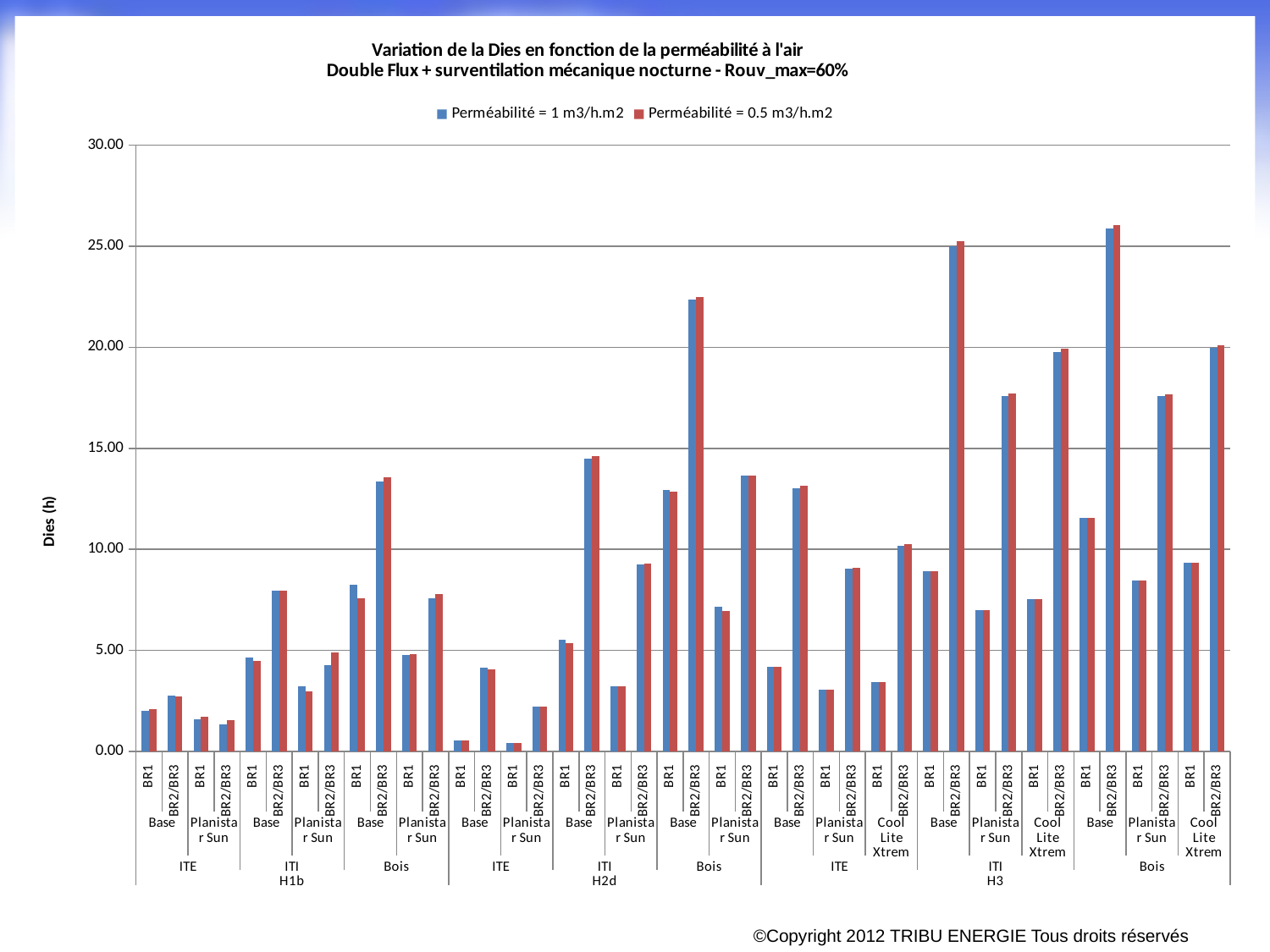
For Perméabilité = 1 m3/h.m2, which is larger: H2d Bois Base BR2/BR3 or H3 ITI Base BR2/BR3? H3 ITI Base BR2/BR3 Is the value for H2d ITI Base BR2/BR3 (Perméabilité = 1 m3/h.m2) greater or less than 15.00? less Is the value for H3 Bois Planistar Sun BR2/BR3 (Perméabilité = 0.5 m3/h.m2) greater or less than 15.00? greater Which category has the highest value for Perméabilité = 1 m3/h.m2? H3 Bois Base BR2/BR3 For Perméabilité = 0.5 m3/h.m2, which is larger: H1b Bois Base BR2/BR3 or H2d ITI Base BR2/BR3? H2d ITI Base BR2/BR3 Is the value for H1b Bois Base BR2/BR3 (Perméabilité = 0.5 m3/h.m2) greater or less than 10.00? greater Which series is shown in red in the legend? Perméabilité = 0.5 m3/h.m2 How many series does the legend list? 2 What is the label of the vertical axis? Dies (h) What kind of chart is shown on the slide? bar chart